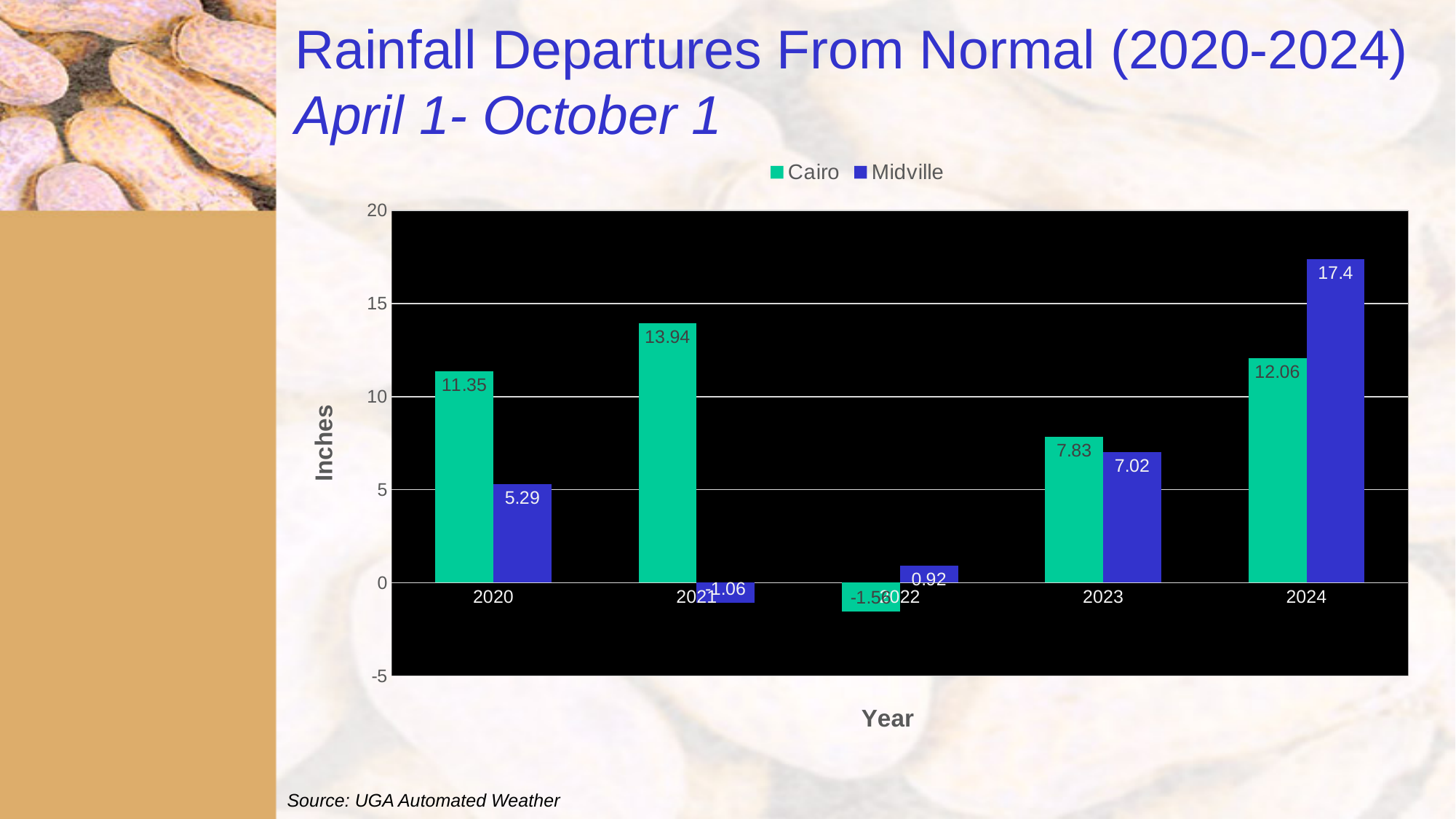
How many years are shown on the x axis? 5 What is the rainfall departure for Midville in 2022? 0.92 In which year is the Midville value lowest? 2021 In 2024, which location has the larger value, Cairo or Midville? Midville What is the difference between the Cairo and Midville values in 2023? 0.81 What is the rainfall departure for Cairo in 2020? 11.35 What is the difference between the Midville and Cairo values in 2024? 5.34 What is the rainfall departure for Midville in 2024? 17.4 What kind of chart is shown on the slide? Bar chart In which year is the Cairo value highest? 2021 How many series does the legend list? 2 What is the label on the y axis? Inches